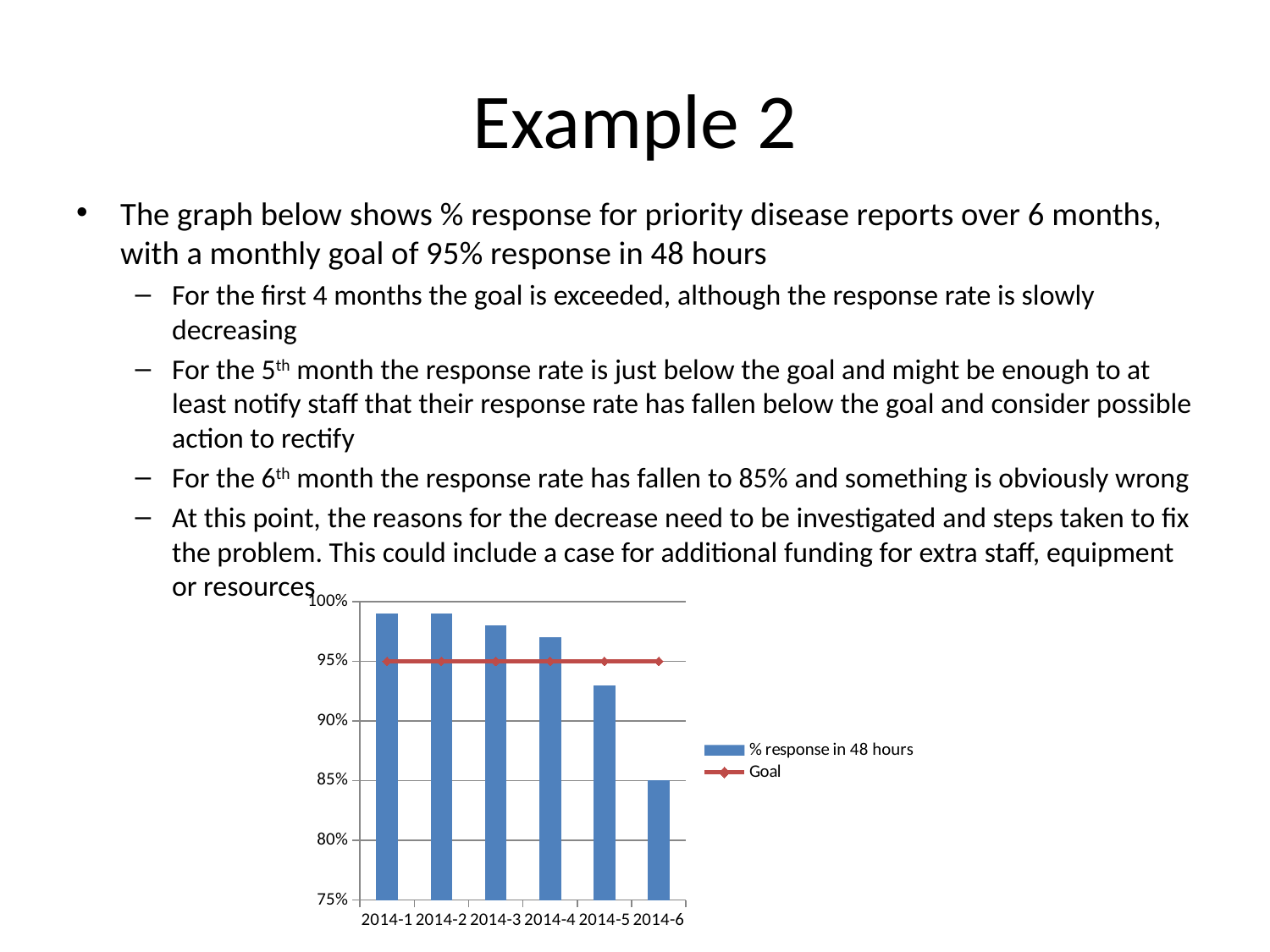
Do the % response in 48 hours values rise or fall from 2014-1 to 2014-6? fall What are the two entries listed in the chart legend? % response in 48 hours; Goal Which month has the lowest % response in 48 hours? 2014-6 Is the % response in 48 hours for 2014-5 greater or less than 90%? greater What value does the Goal line sit at? 95% Is the % response in 48 hours for 2014-5 greater or less than 95%? less Is the % response in 48 hours for 2014-1 greater or less than 95%? greater What is the % response in 48 hours for 2014-6? 85% What kind of chart is shown on the slide? combination bar and line chart How many series does the chart legend list? 2 How many months (categories) are shown on the x axis of the chart? 6 Which month has the higher % response in 48 hours, 2014-4 or 2014-5? 2014-4